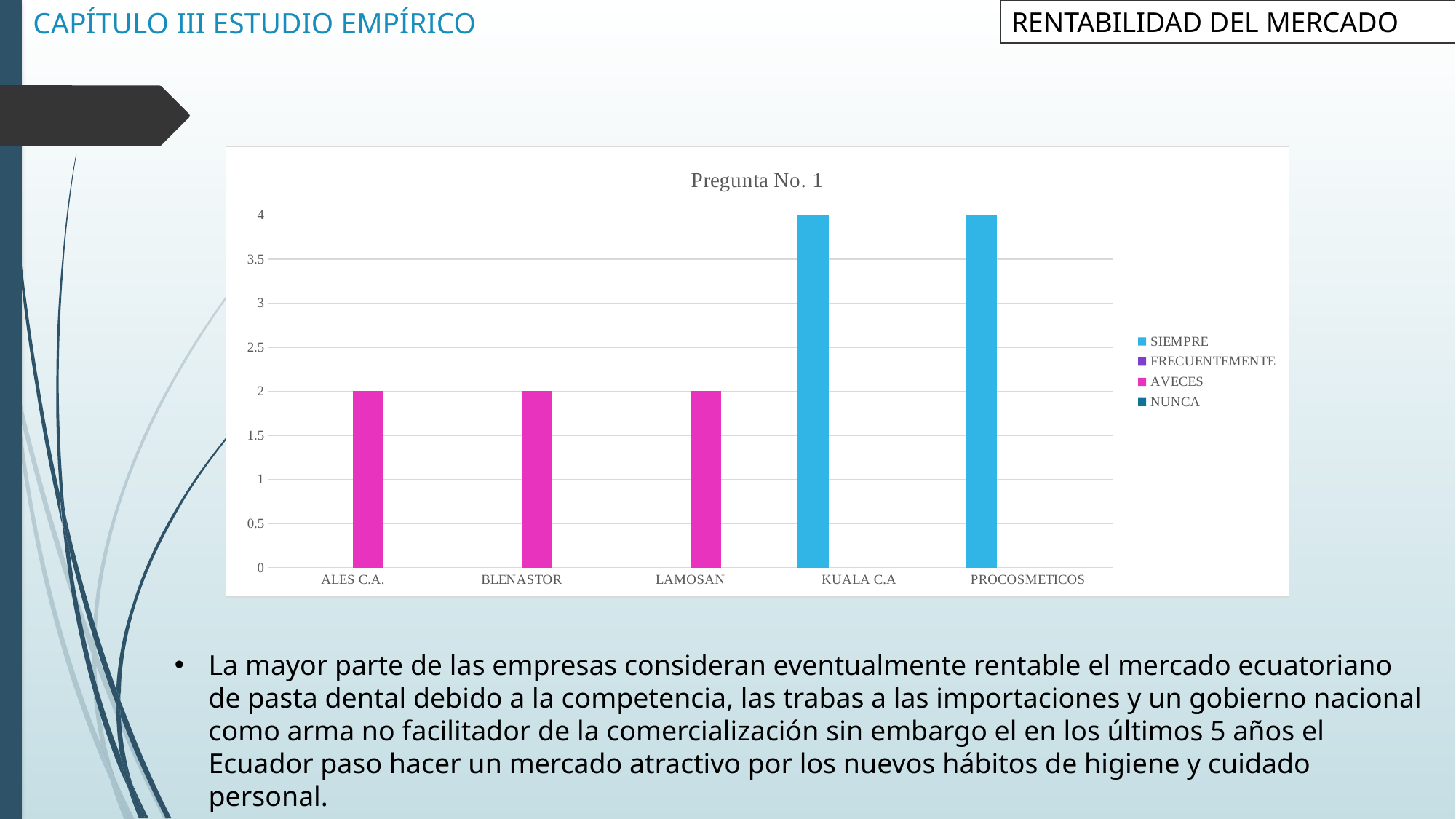
How many series does the chart's legend list? 4 What is the difference between the value for PROCOSMETICOS and the value for BLENASTOR? 2 What kind of chart is shown on the slide? bar chart What is the value for LAMOSAN? 2 Is the value for LAMOSAN greater or less than 3? less Which is larger, the value for BLENASTOR or the value for PROCOSMETICOS? PROCOSMETICOS How many companies are shown on the x axis of the chart? 5 Is the value for KUALA C.A greater or less than 3? greater What is the value for KUALA C.A? 4 What is the title of the chart? Pregunta No. 1 What is the value for ALES C.A.? 2 Which legend series do the bars for KUALA C.A and PROCOSMETICOS belong to? SIEMPRE